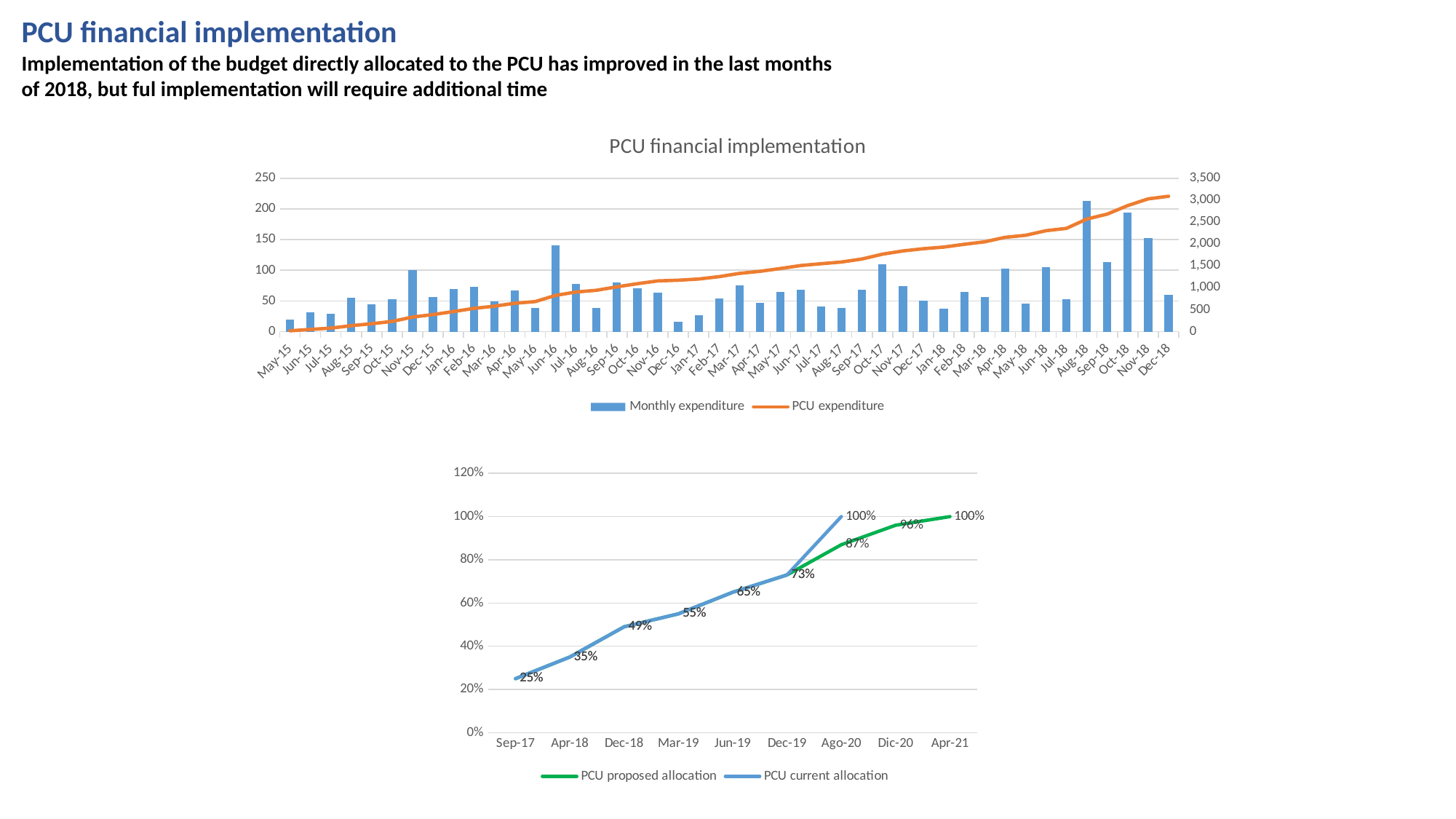
In the bottom chart, what is the PCU proposed allocation value at Dic-20? 96% In the top chart titled 'PCU financial implementation', what kind of chart is it? A combination bar and line chart In the top chart titled 'PCU financial implementation', is the Monthly expenditure for Aug-18 greater or less than 200? greater In the top chart titled 'PCU financial implementation', does the PCU expenditure line rise or fall from May-15 to Dec-18? Rise In the bottom chart, how many categories are shown on the x axis? 9 In the bottom chart, what value does the PCU current allocation line reach at Ago-20? 100% In the bottom chart, what is the difference between the values at Dec-19 (73%) and Jun-19 (65%)? 8 percentage points In the bottom chart, what is the value labelled at Dec-18? 49% In the top chart titled 'PCU financial implementation', which month has the lowest Monthly expenditure bar? Dec-16 In the top chart titled 'PCU financial implementation', how many series does the legend list? 2 In the top chart titled 'PCU financial implementation', which month has the highest Monthly expenditure bar? Aug-18 In the top chart titled 'PCU financial implementation', is the Monthly expenditure for Jun-16 greater or less than 100? greater